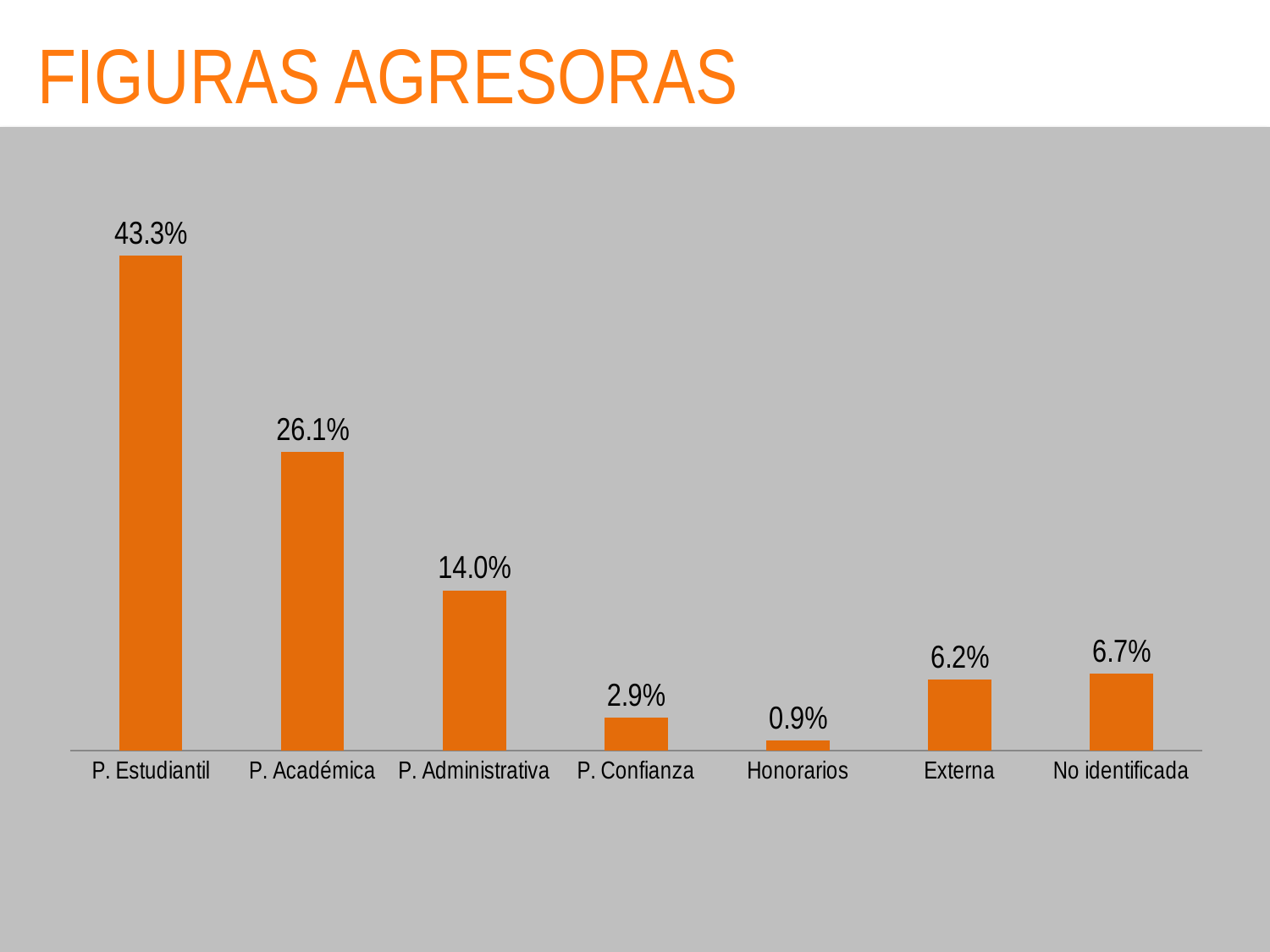
What kind of chart is shown on the slide? Bar chart What is the difference between the values for P. Estudiantil and P. Académica? 17.2% Which category has the highest value? P. Estudiantil How many categories are shown on the x axis? 7 What is the value for Honorarios? 0.9% Which category has the lowest value? Honorarios What is the value for P. Estudiantil? 43.3% What is the difference between the values for No identificada and Externa? 0.5% What colour are the bars in the chart? Orange What is the value for P. Administrativa? 14.0% What is the title of the slide? FIGURAS AGRESORAS Which is larger, the value for P. Confianza or the value for Externa? Externa